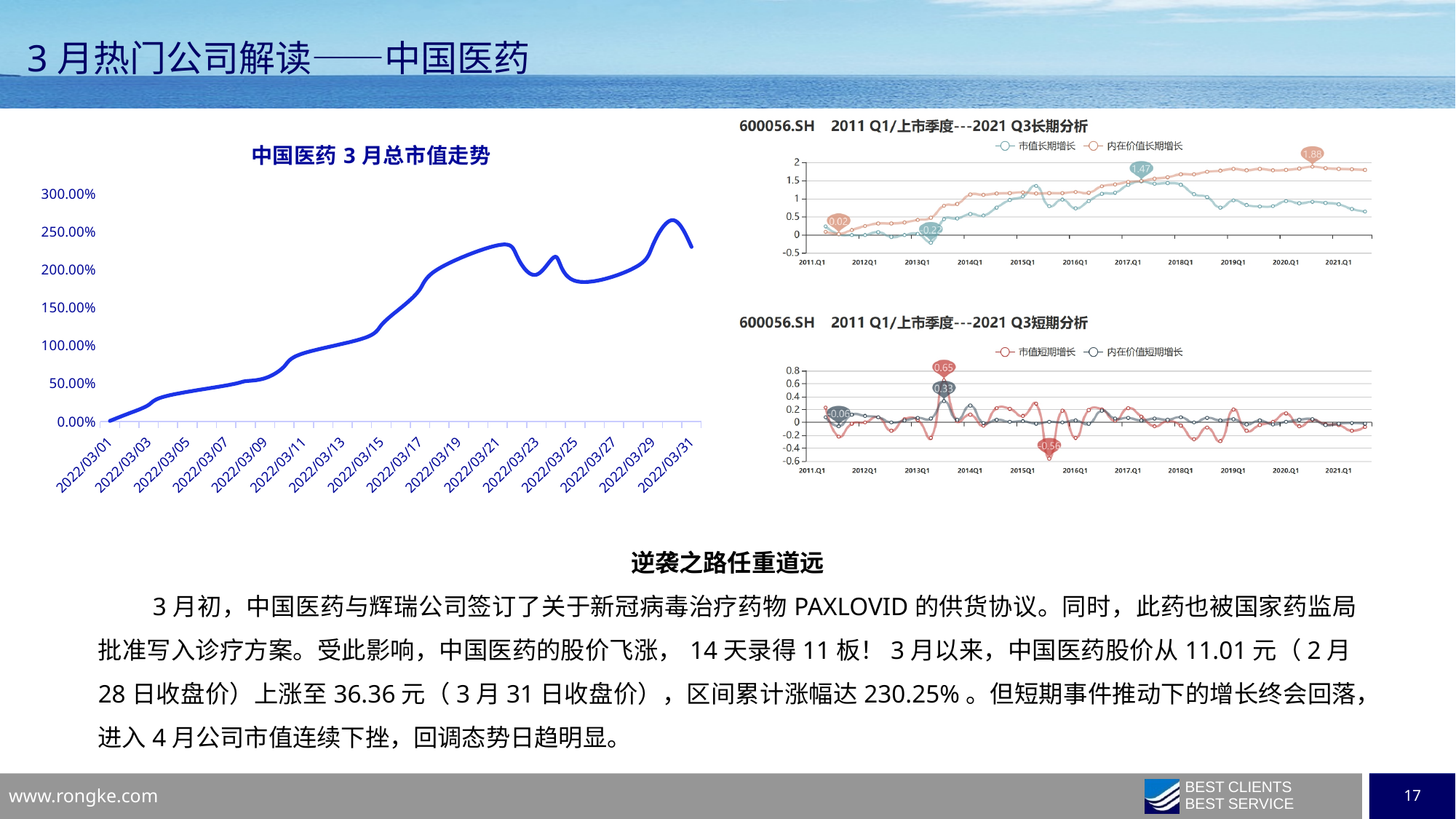
In the '600056.SH 2011 Q1/上市季度---2021 Q3长期分析' chart, what is the highest labelled value of the 内在价值长期增长 series? 1.88 In the '中国医药 3 月总市值走势' chart, is the highest point of the line greater or less than 300.00%? less In the '中国医药 3 月总市值走势' chart, is the value on 2022/03/31 greater or less than 200.00%? greater In the '600056.SH 2011 Q1/上市季度---2021 Q3短期分析' chart, what is the highest labelled value of the 市值短期增长 series? 0.65 In the '600056.SH 2011 Q1/上市季度---2021 Q3短期分析' chart, what is the lowest labelled value of the 市值短期增长 series? -0.56 In the '中国医药 3 月总市值走势' chart, do the values generally rise or fall from 2022/03/01 to 2022/03/31? rise What kind of chart is the '中国医药 3 月总市值走势' chart on the left? line chart In the '600056.SH 2011 Q1/上市季度---2021 Q3长期分析' chart, what is the lowest labelled value of the 市值长期增长 series? -0.22 In the '600056.SH 2011 Q1/上市季度---2021 Q3长期分析' chart, how many series does the legend list? 2 In the '600056.SH 2011 Q1/上市季度---2021 Q3长期分析' chart, what is the labelled peak value of the 市值长期增长 series around 2017? 1.47